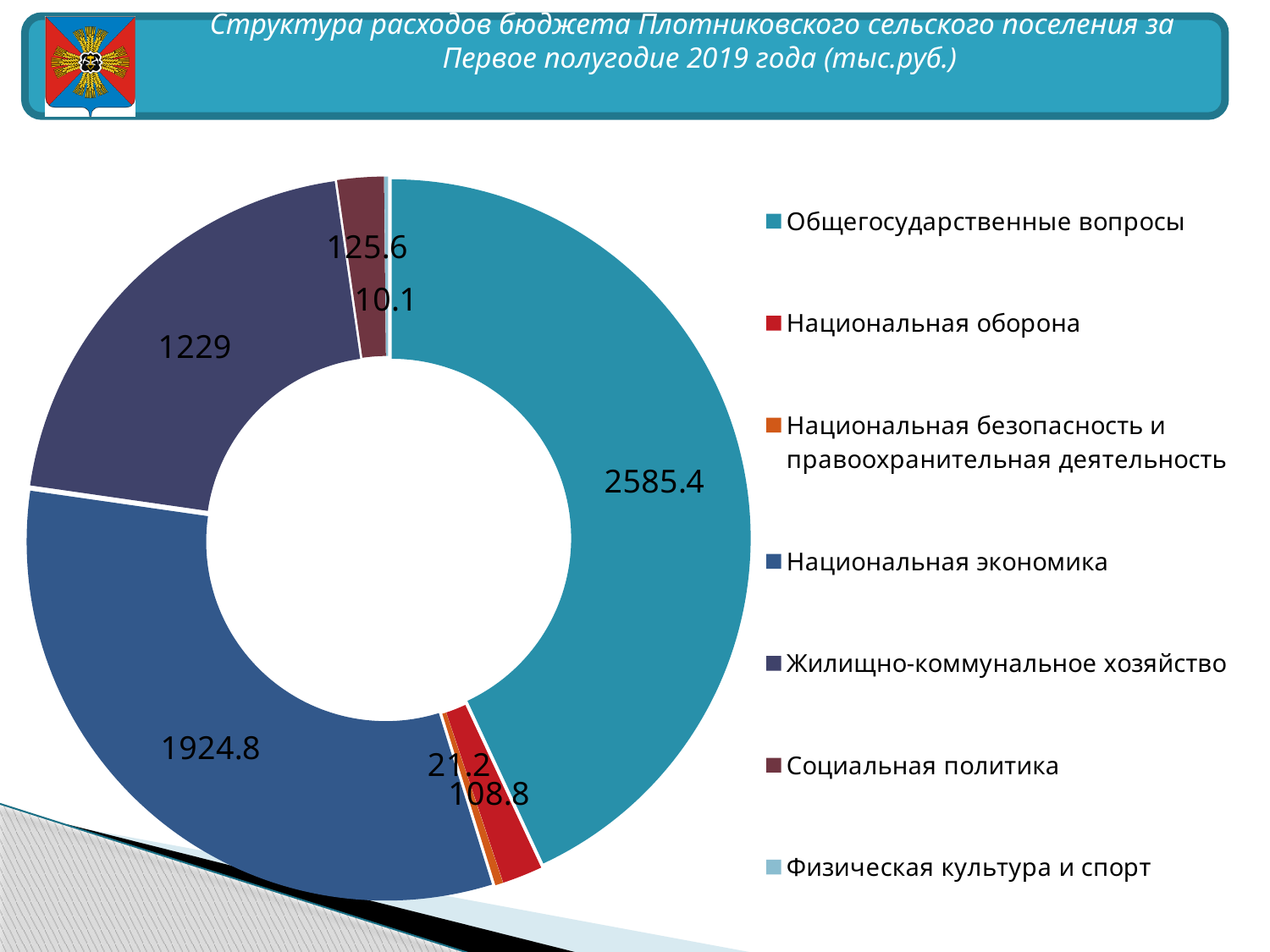
What kind of chart is shown on the slide? Doughnut (pie) chart What is the value for Национальная экономика? 1924.8 Which category has the highest value? Общегосударственные вопросы How many categories does the legend list? 7 What is the value for Общегосударственные вопросы? 2585.4 What is the value for Национальная оборона? 108.8 What is the value for Жилищно-коммунальное хозяйство? 1229 What is the difference between Национальная экономика and Жилищно-коммунальное хозяйство? 695.8 Which category has the lowest value? Физическая культура и спорт What is the value for Социальная политика? 125.6 What is the difference between Общегосударственные вопросы and Национальная экономика? 660.6 Which is larger, Социальная политика or Национальная оборона? Социальная политика